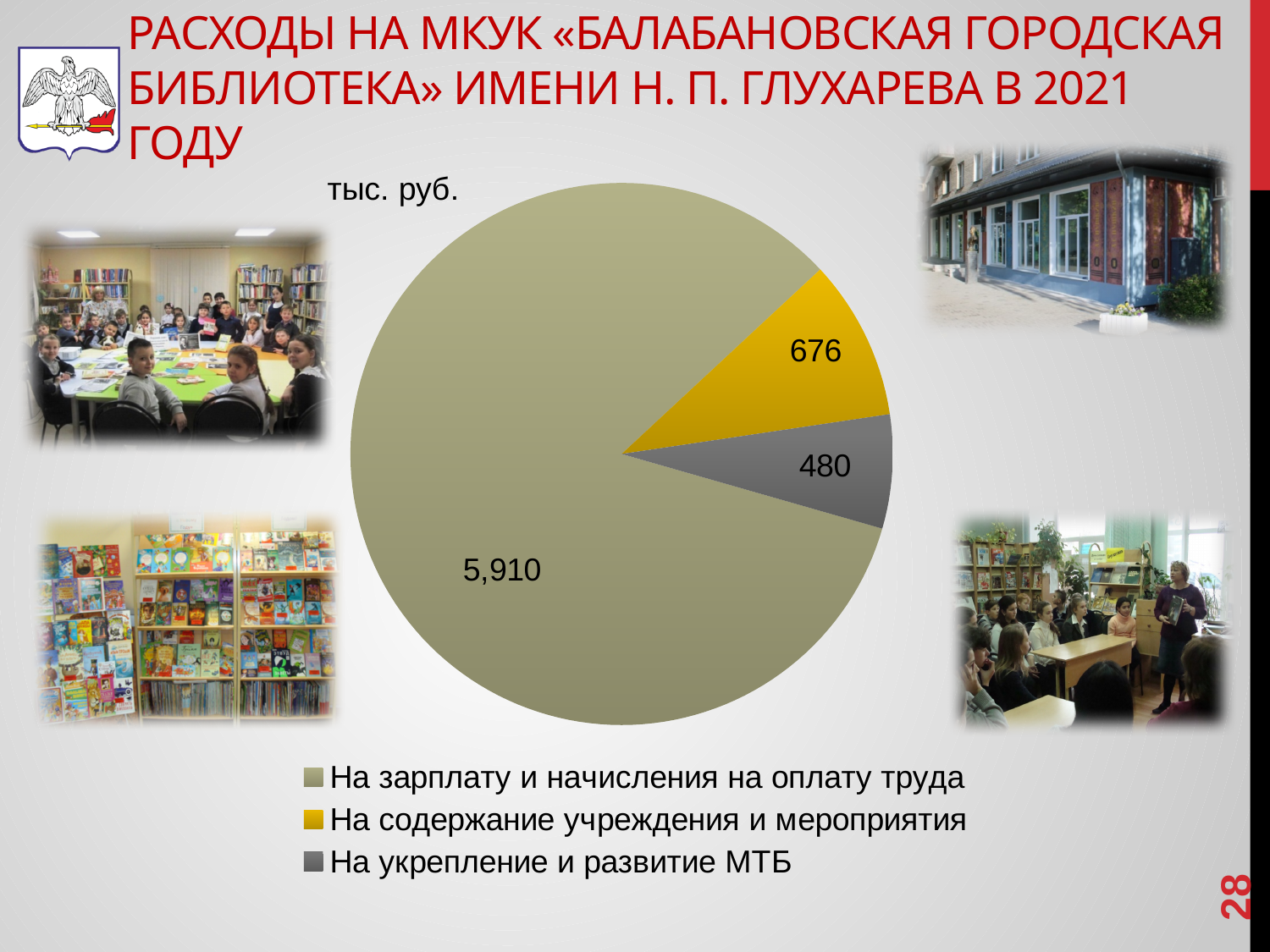
What is the value for «На зарплату и начисления на оплату труда»? 5,910 How many entries does the legend list? 3 Which is larger: the value for «На содержание учреждения и мероприятия» or for «На укрепление и развитие МТБ»? На содержание учреждения и мероприятия What unit is indicated for the values in the chart? тыс. руб. Which category has the largest slice of the pie? На зарплату и начисления на оплату труда What is the difference between the values for «На содержание учреждения и мероприятия» and «На укрепление и развитие МТБ»? 196 How many slices does the pie chart have? 3 Which category has the smallest slice of the pie? На укрепление и развитие МТБ What is the value for «На укрепление и развитие МТБ»? 480 What is the value for «На содержание учреждения и мероприятия»? 676 What is the total of all slices in the pie chart? 7,066 What kind of chart is shown on the slide? pie chart